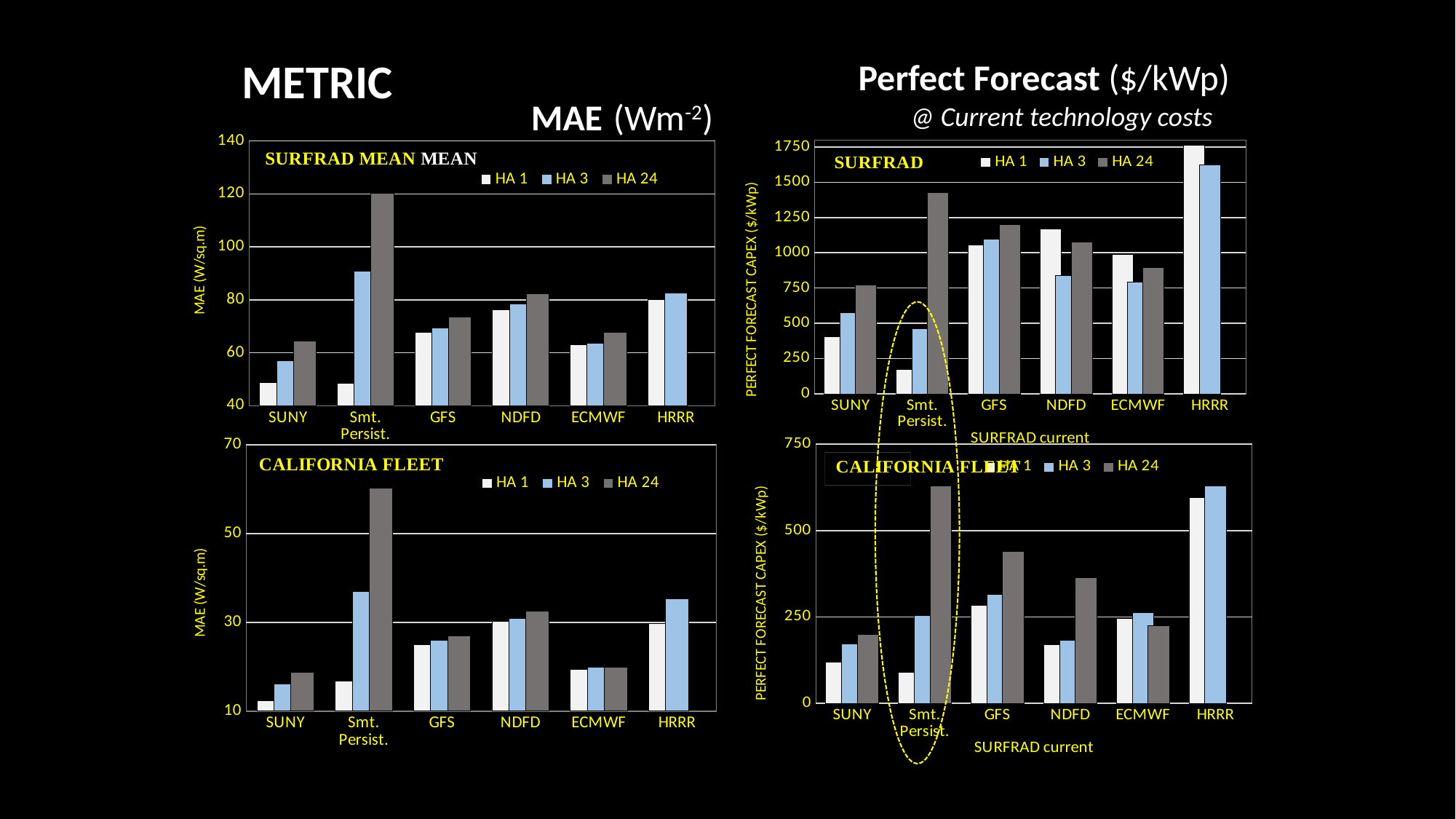
In the top-left SURFRAD MEAN MAE chart, which category has the tallest HA 24 bar? Smt. Persist. In the top-right SURFRAD Perfect Forecast chart, which category has the highest HA 1 bar? HRRR In the top-right SURFRAD Perfect Forecast chart, for NDFD, which is larger: HA 1 or HA 3? HA 1 How many categories are shown on the x axis of the top-left SURFRAD MEAN MAE chart? 6 In the bottom-right CALIFORNIA FLEET Perfect Forecast chart, is the HA 3 value for HRRR greater or less than 500? greater In the bottom-left CALIFORNIA FLEET MAE chart, which category has the lowest HA 1 bar? SUNY What kind of chart is the top-right SURFRAD Perfect Forecast chart? bar chart How many series does the legend of the bottom-left CALIFORNIA FLEET MAE chart list? 3 In the top-right SURFRAD Perfect Forecast chart, which category has the lowest HA 1 bar? Smt. Persist. In the bottom-left CALIFORNIA FLEET MAE chart, is the HA 24 value for Smt. Persist. greater or less than 50? greater In the top-left SURFRAD MEAN MAE chart, is the HA 24 value for Smt. Persist. greater or less than 100? greater